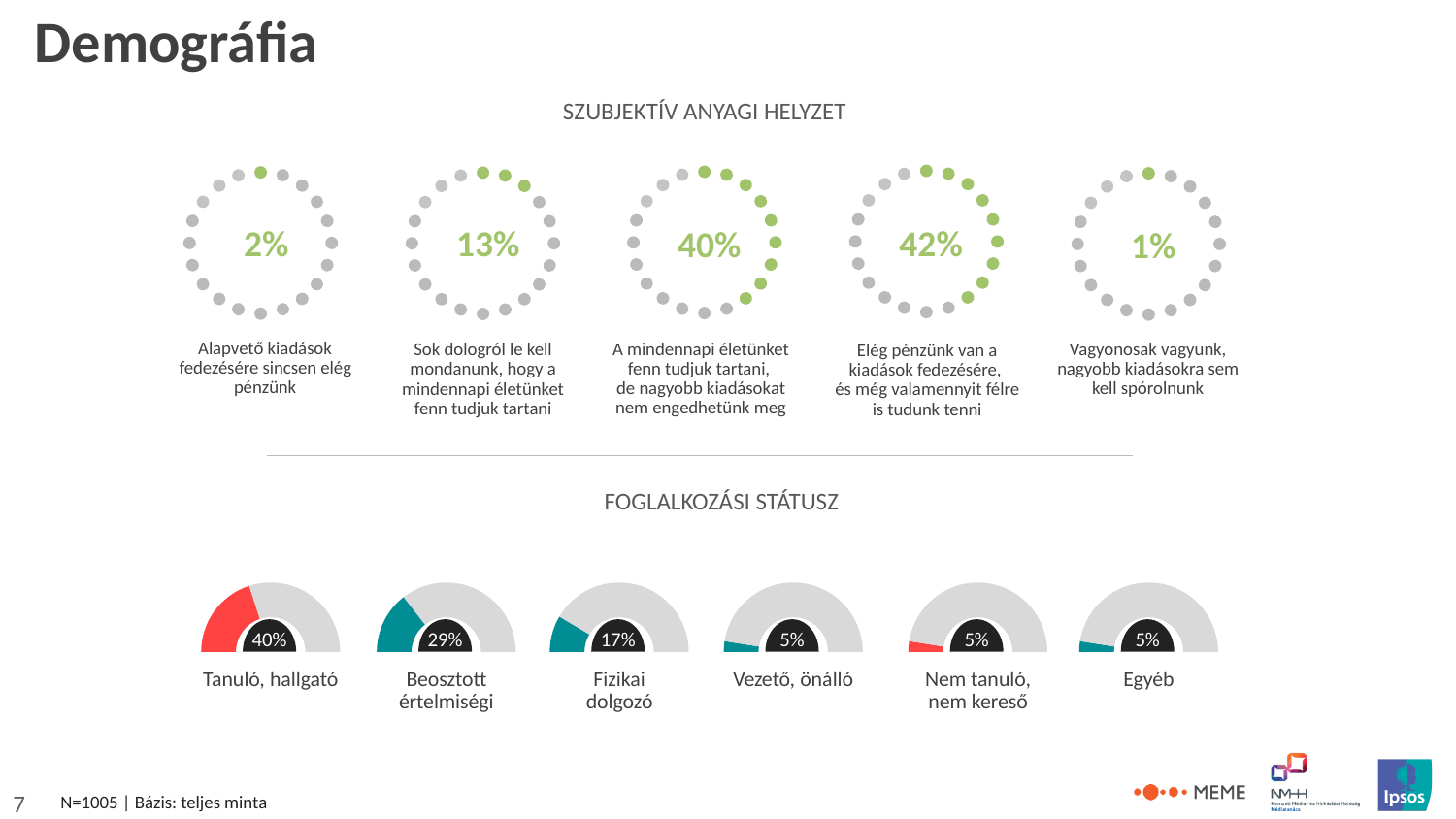
In the SZUBJEKTÍV ANYAGI HELYZET section, which category has the lowest percentage? Vagyonosak vagyunk, nagyobb kiadásokra sem kell spórolnunk In the FOGLALKOZÁSI STÁTUSZ section, what percentage is shown for "Tanuló, hallgató"? 40% In the FOGLALKOZÁSI STÁTUSZ section, what percentage is shown for "Beosztott értelmiségi"? 29% How many categories are shown in the SZUBJEKTÍV ANYAGI HELYZET section? 5 In the SZUBJEKTÍV ANYAGI HELYZET section, what is the difference between the 42% and 40% categories? 2% In the FOGLALKOZÁSI STÁTUSZ section, which is larger: "Beosztott értelmiségi" or "Fizikai dolgozó"? Beosztott értelmiségi In the SZUBJEKTÍV ANYAGI HELYZET section, what percentage is shown for "Elég pénzünk van a kiadások fedezésére, és még valamennyit félre is tudunk tenni"? 42% How many categories are shown in the FOGLALKOZÁSI STÁTUSZ section? 6 In the SZUBJEKTÍV ANYAGI HELYZET section, which category has the highest percentage? Elég pénzünk van a kiadások fedezésére, és még valamennyit félre is tudunk tenni In the FOGLALKOZÁSI STÁTUSZ section, what is the difference between "Tanuló, hallgató" and "Fizikai dolgozó"? 23% In the FOGLALKOZÁSI STÁTUSZ section, which category has the highest percentage? Tanuló, hallgató In the SZUBJEKTÍV ANYAGI HELYZET section, what percentage is shown for "Alapvető kiadások fedezésére sincsen elég pénzünk"? 2%